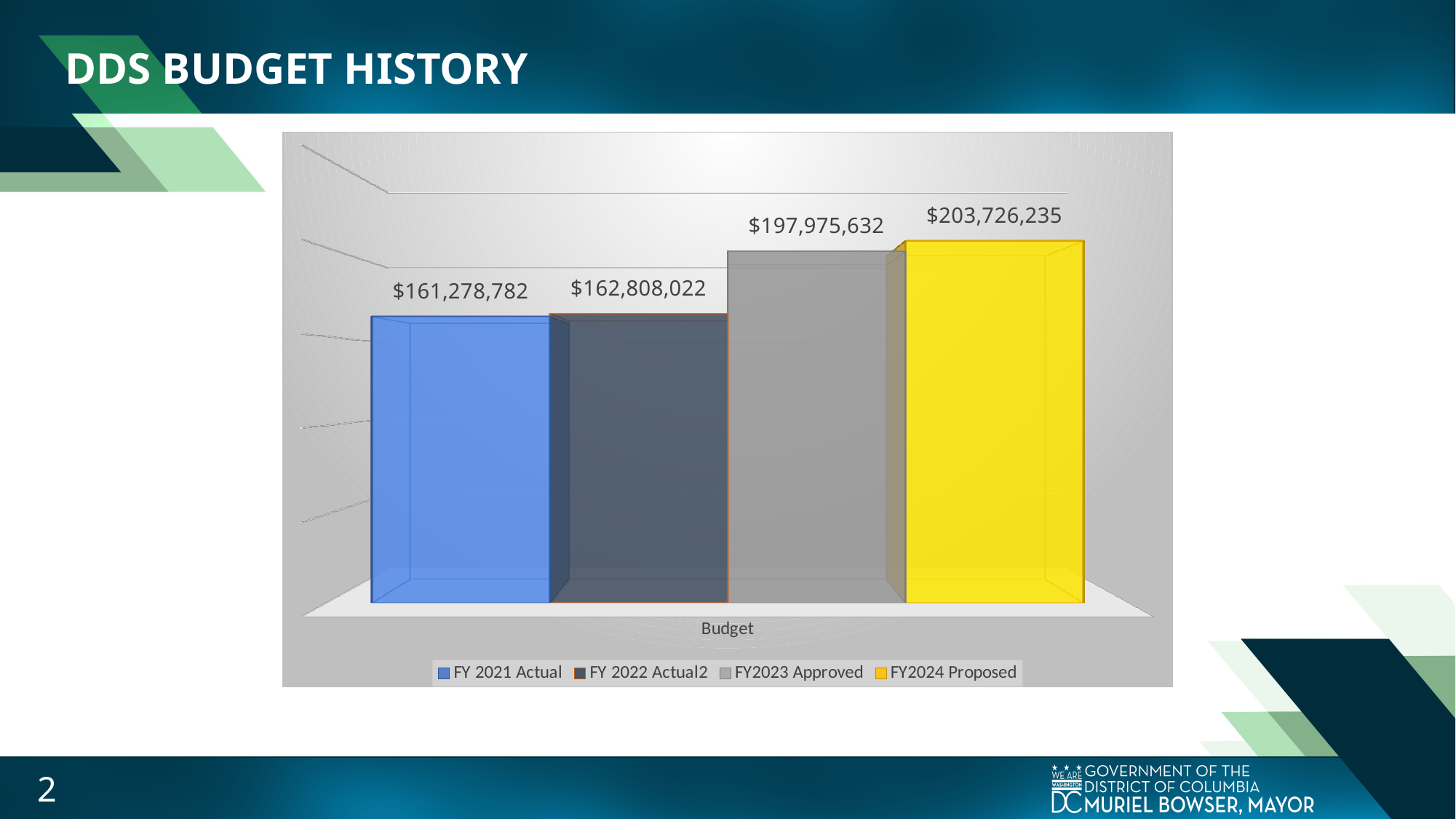
What is the value for FY 2022 Actual2? $162,808,022 What colour is the bar for FY2024 Proposed? Yellow Which series has the lowest value? FY 2021 Actual What is the value for FY2023 Approved? $197,975,632 What is the value for FY2024 Proposed? $203,726,235 Which series has the highest value? FY2024 Proposed What kind of chart is shown on the slide? Bar chart What is the difference between the FY2023 Approved and FY 2022 Actual2 values? $35,167,610 What is the value for FY 2021 Actual? $161,278,782 Which is larger, the FY2023 Approved value or the FY 2022 Actual2 value? FY2023 Approved How many series does the legend list? 4 What is the difference between the FY2024 Proposed and FY2023 Approved values? $5,750,603